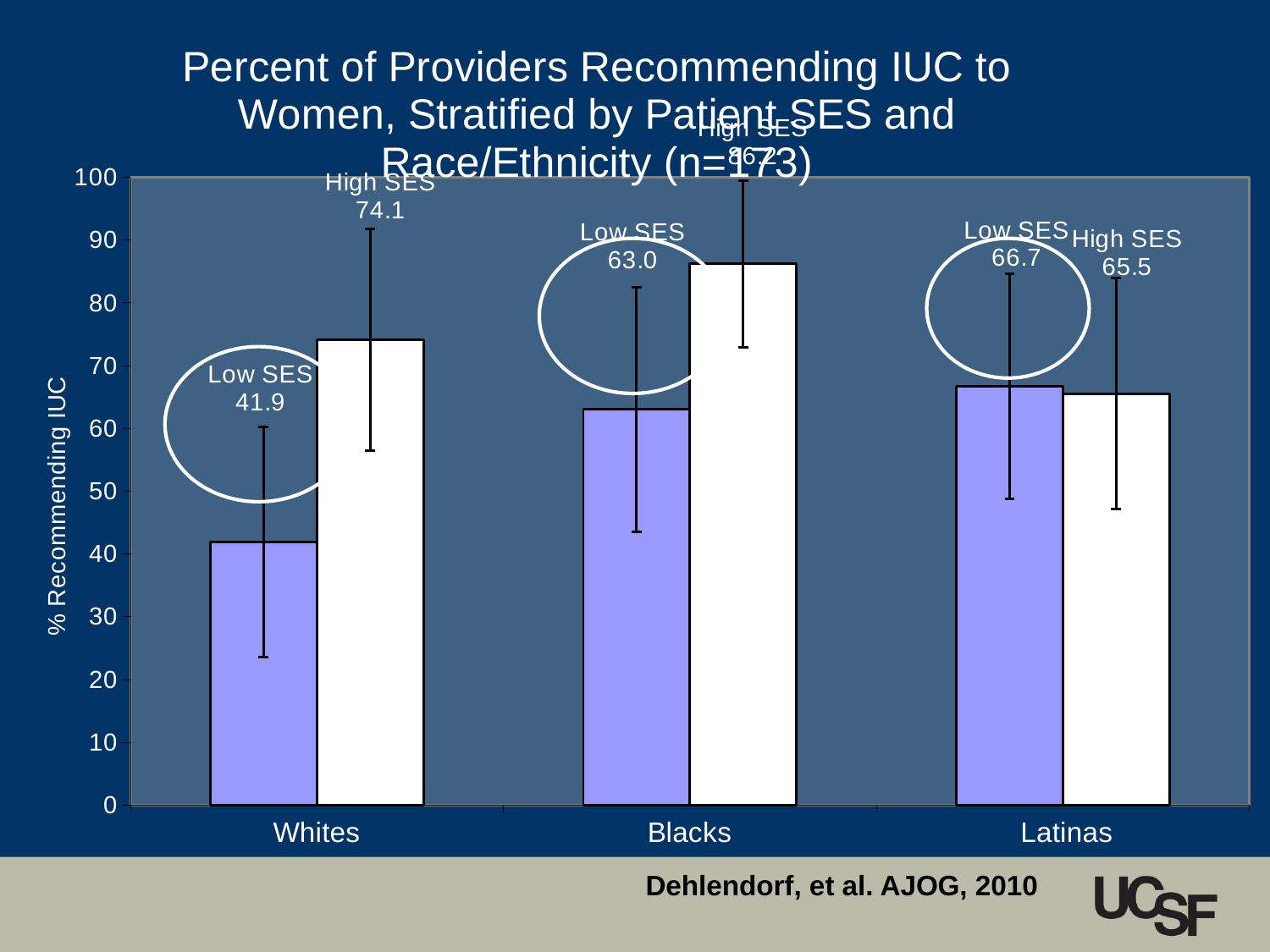
What is the difference between the High SES and Low SES values for Whites? 32.2 What is the value for High SES Latinas? 65.5 What is the value for Low SES Latinas? 66.7 What is the value for Low SES Blacks? 63.0 What percent of providers recommended IUC to Low SES White women? 41.9 What is the label of the y axis? % Recommending IUC Is the value for High SES Blacks greater or less than 80? greater How many race/ethnicity categories are shown on the x axis? 3 What is the value for High SES Whites? 74.1 Which race/ethnicity group has the lowest Low SES value? Whites Which is larger for Whites, the Low SES value or the High SES value? High SES What kind of chart is shown on the slide? Bar chart